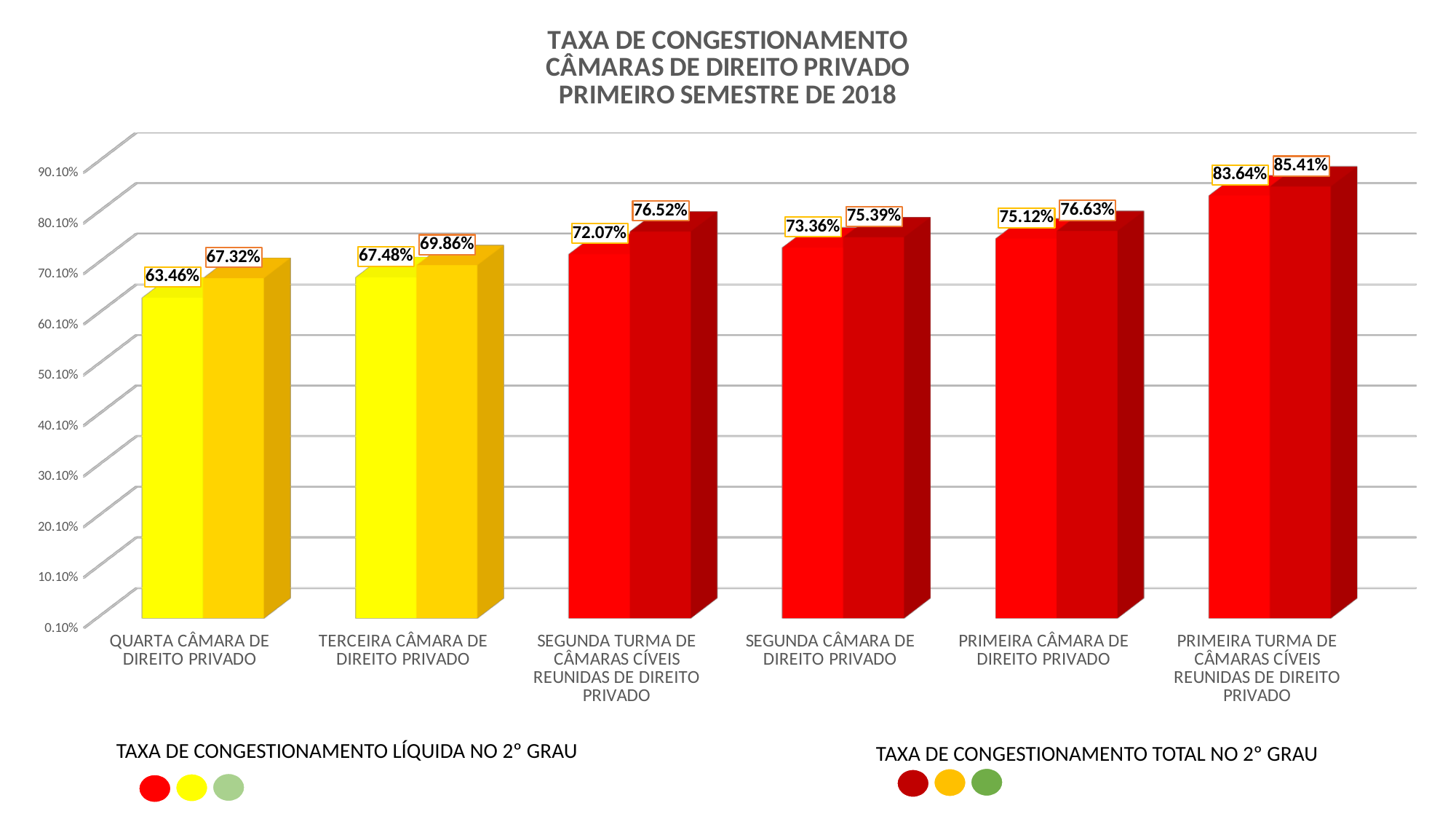
What is the 'Taxa de congestionamento líquida no 2º grau' value for Quarta Câmara de Direito Privado? 63.46% What is the 'Taxa de congestionamento total no 2º grau' value for Segunda Câmara de Direito Privado? 75.39% What kind of chart is shown on the slide? Bar chart Which category has the highest 'Taxa de congestionamento líquida no 2º grau'? Primeira Turma de Câmaras Cíveis Reunidas de Direito Privado How many categories are shown on the x axis? 6 What is the difference between the 'Taxa de congestionamento total no 2º grau' and the 'Taxa de congestionamento líquida no 2º grau' for Segunda Turma de Câmaras Cíveis Reunidas de Direito Privado? 4.45% Which category has the lowest 'Taxa de congestionamento total no 2º grau'? Quarta Câmara de Direito Privado What is the 'Taxa de congestionamento total no 2º grau' value for Primeira Turma de Câmaras Cíveis Reunidas de Direito Privado? 85.41% Which is larger: the 'Taxa de congestionamento líquida no 2º grau' for Primeira Câmara de Direito Privado or for Terceira Câmara de Direito Privado? Primeira Câmara de Direito Privado How many series does the legend list? 2 Do the 'Taxa de congestionamento líquida no 2º grau' values rise or fall from left to right along the x axis? Rise Is the 'Taxa de congestionamento líquida no 2º grau' for Primeira Turma de Câmaras Cíveis Reunidas de Direito Privado greater or less than 80.10%? greater